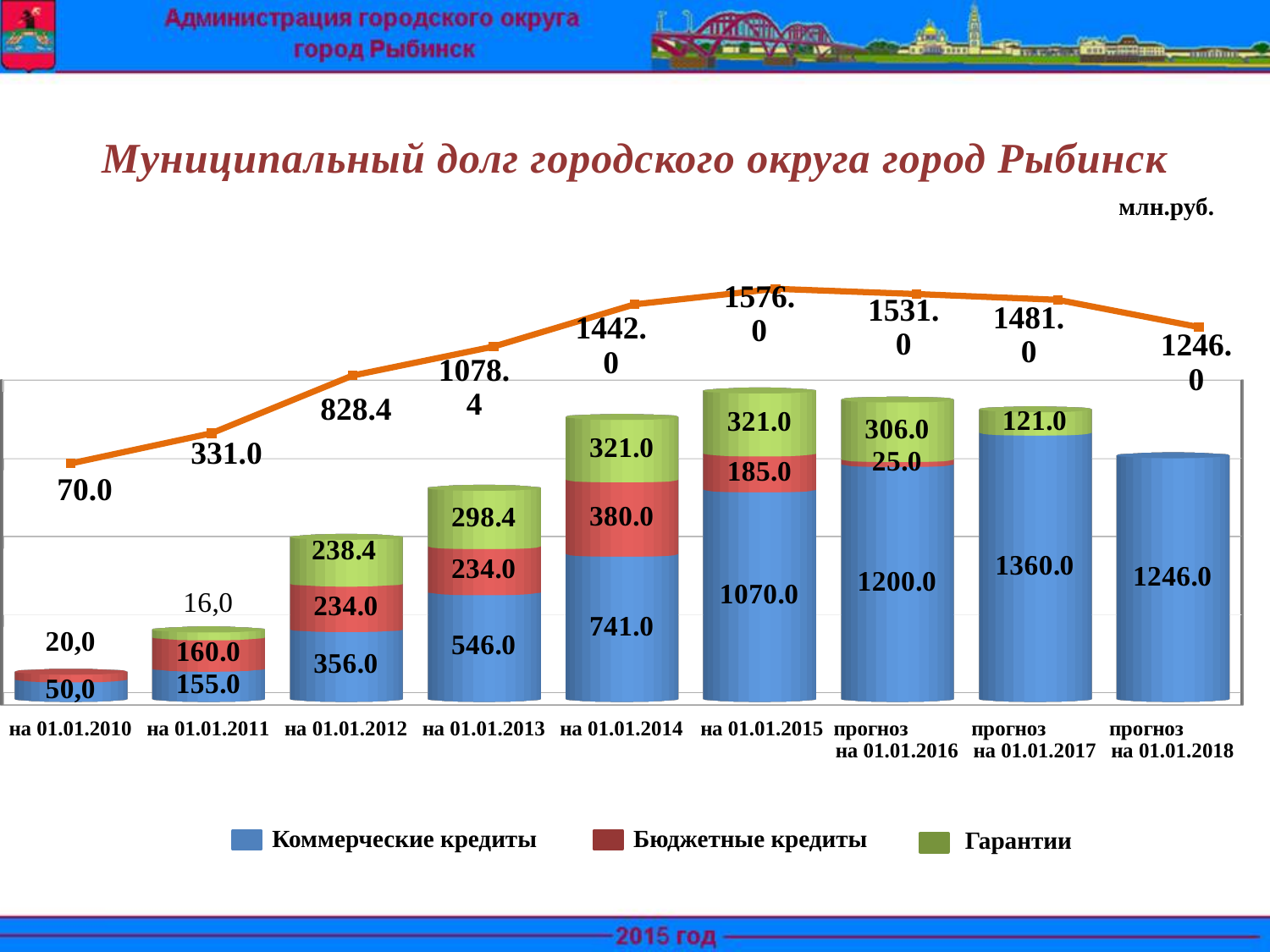
At which date is the total municipal debt on the line highest? на 01.01.2015 What is the value of Гарантии for прогноз на 01.01.2016? 306.0 What is the total municipal debt shown on the line for на 01.01.2013? 1078.4 At which date is the total municipal debt on the line lowest? на 01.01.2010 What is the difference between Коммерческие кредиты for прогноз на 01.01.2017 and for на 01.01.2015? 290.0 Which is larger: Бюджетные кредиты for на 01.01.2014 or Гарантии for на 01.01.2014? Бюджетные кредиты (380.0) What is the value of Коммерческие кредиты for на 01.01.2014? 741.0 How many series does the legend list? 3 How many dates (categories) are shown on the x axis? 9 What is the value of Бюджетные кредиты for на 01.01.2015? 185.0 What unit is stated for the values on the chart? млн.руб. What kind of chart is this? Stacked bar chart with a line